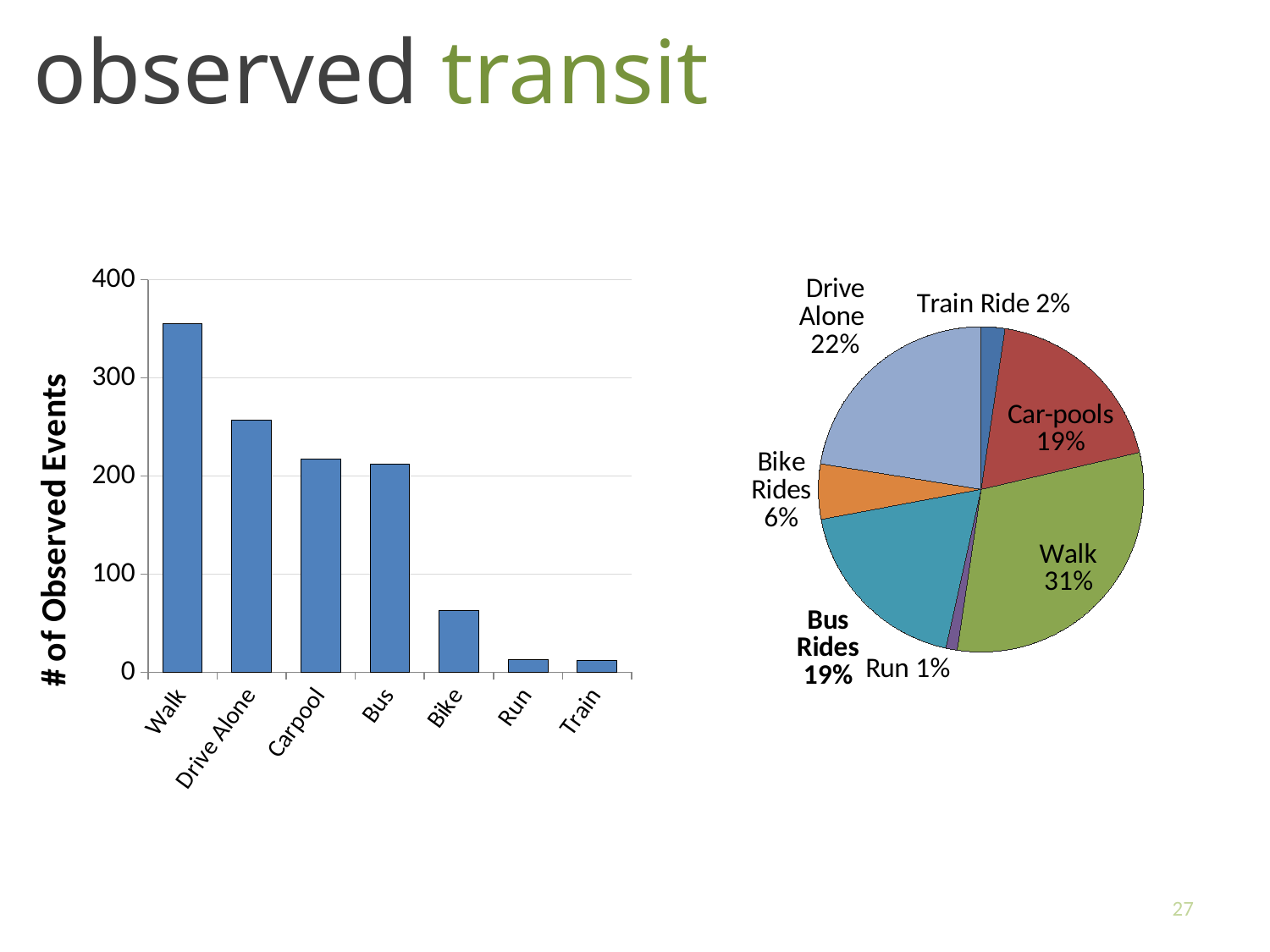
In the pie chart on the right, which slice is the smallest? Run In the bar chart on the left, what is the label of the y axis? # of Observed Events What kind of chart is the chart on the right of the slide? pie chart What kind of chart is the chart on the left of the slide? bar chart In the bar chart on the left, how many categories are shown on the x axis? 7 In the pie chart on the right, what share does Walk have? 31% In the pie chart on the right, what is the difference between the Drive Alone share and the Bike Rides share? 16% In the bar chart on the left, which is larger, the value for Drive Alone or the value for Bike? Drive Alone In the bar chart on the left, is the value for Drive Alone greater or less than 200? greater In the bar chart on the left, is the value for Bike greater or less than 100? less In the bar chart on the left, is the value for Walk greater or less than 300? greater In the bar chart on the left, which category has the highest number of observed events? Walk